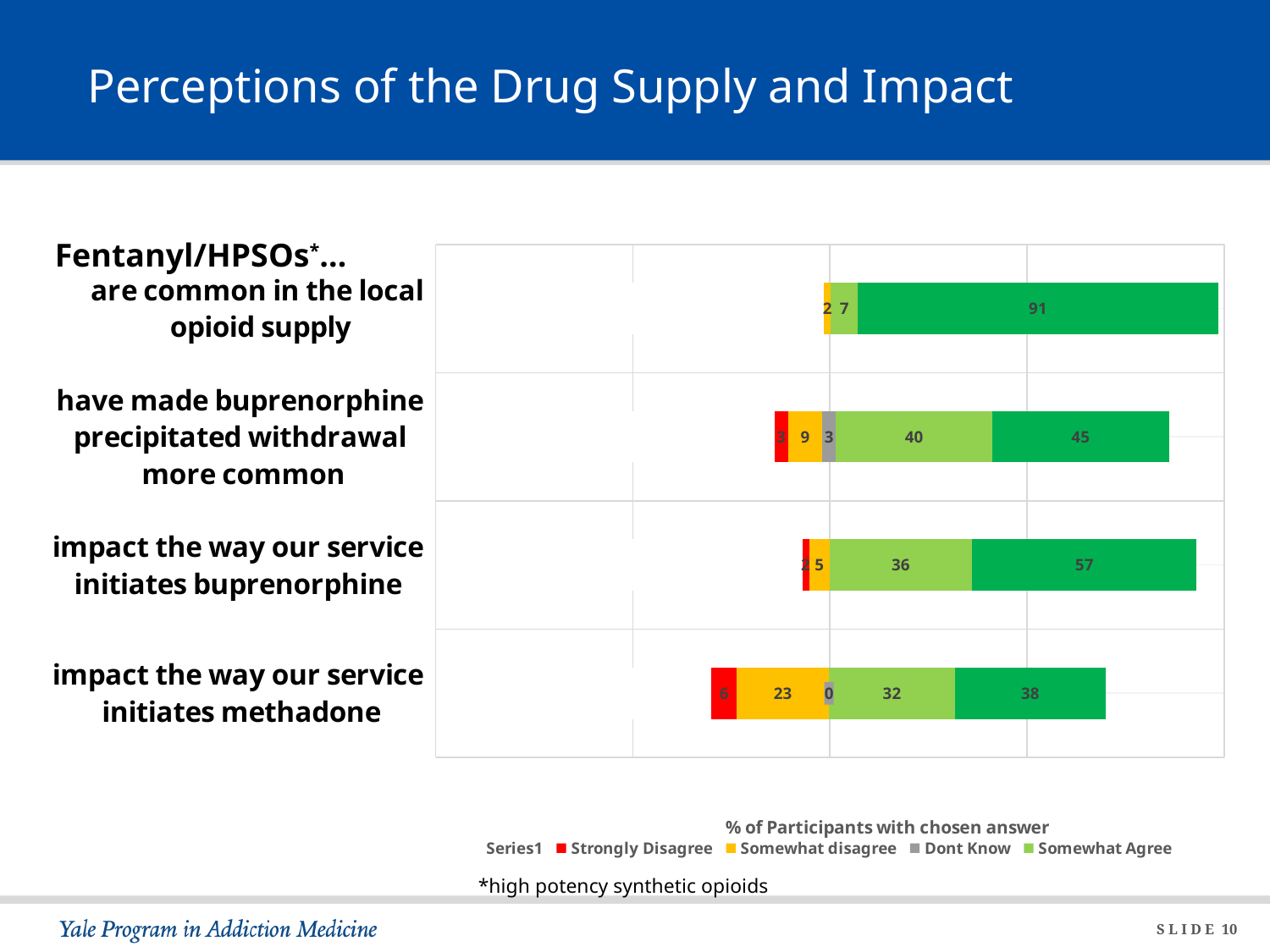
Which statement has the largest dark green segment? are common in the local opioid supply What is the Somewhat Agree value for 'have made buprenorphine precipitated withdrawal more common'? 40 What is the Somewhat Agree value for 'are common in the local opioid supply'? 7 What is the value of the dark green segment for 'are common in the local opioid supply'? 91 What is the difference between the Somewhat Agree values for 'impact the way our service initiates buprenorphine' (36) and 'impact the way our service initiates methadone' (32)? 4 What is the Somewhat disagree value for 'impact the way our service initiates methadone'? 23 What is the Dont Know value for 'impact the way our service initiates methadone'? 0 Which is larger: the Strongly Disagree value for 'impact the way our service initiates methadone' or for 'impact the way our service initiates buprenorphine'? impact the way our service initiates methadone How many statements (categories) are plotted in the chart? 4 Which statement has the highest Somewhat disagree value? impact the way our service initiates methadone How many entries does the chart legend list? 5 What kind of chart is shown on the slide? Stacked bar chart